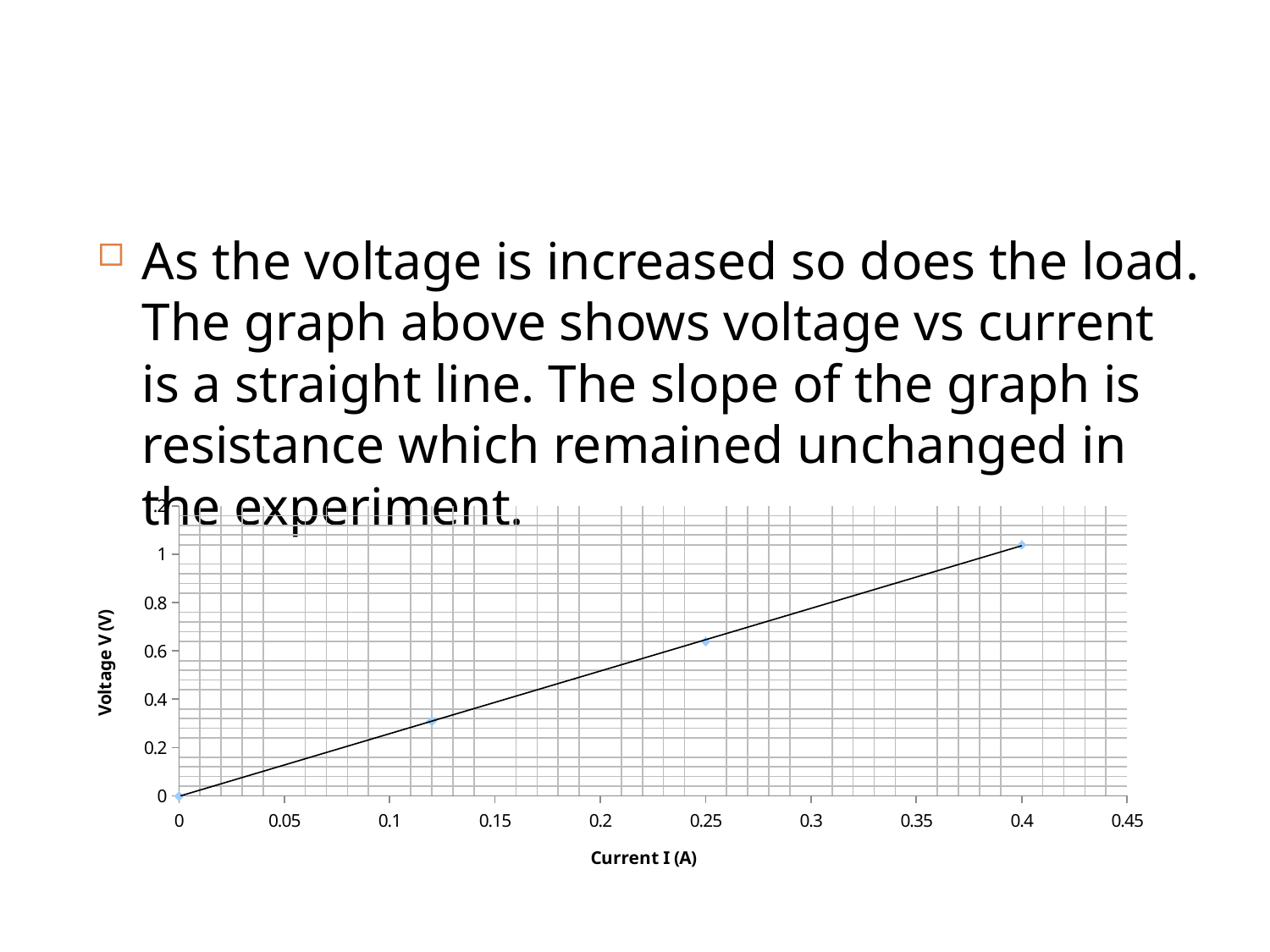
Is the voltage at a current of about 0.12 A greater or less than 0.4? less Do the voltage values rise or fall as current increases along the x axis? rise What is the voltage at a current of 0 A? 0 What kind of chart is shown on the slide? line chart At which current value is the voltage highest? 0.4 Is the voltage at a current of 0.4 A greater or less than 0.8? greater Is the voltage at a current of 0.25 A greater or less than 0.8? less At which current value is the voltage lowest? 0 What is the label of the y axis? Voltage V (V) How many data points are plotted on the chart? 4 What is the label of the x axis? Current I (A) Which is larger, the voltage at 0.25 A or the voltage at 0.4 A? the voltage at 0.4 A